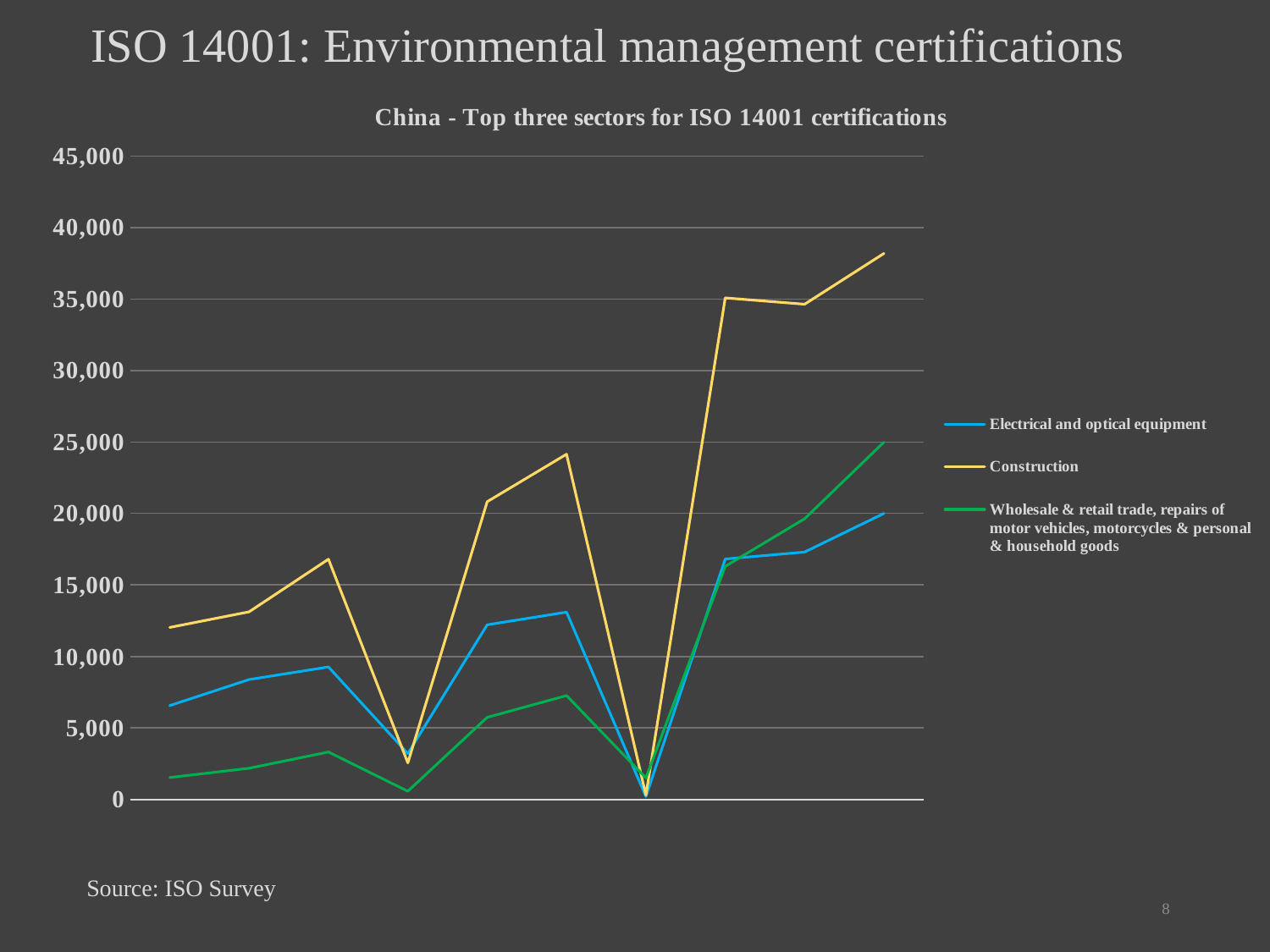
Is the value of Electrical and optical equipment at the last point on the right greater or less than 15,000? greater Which series has the lowest value at the first point on the left? Wholesale & retail trade, repairs of motor vehicles, motorcycles & personal & household goods Does the Construction line end higher or lower than it starts? higher What kind of chart is shown on the slide? Line chart How many series does the legend list? 3 Is the value of Electrical and optical equipment at the first point on the left greater or less than 5,000? greater What is the title of the chart? China - Top three sectors for ISO 14001 certifications Which series reaches the highest value on the chart? Construction At the last point on the right, which is larger: Construction or Electrical and optical equipment? Construction Is the value of Construction at the last point on the right greater or less than 35,000? greater Which series is drawn in yellow? Construction